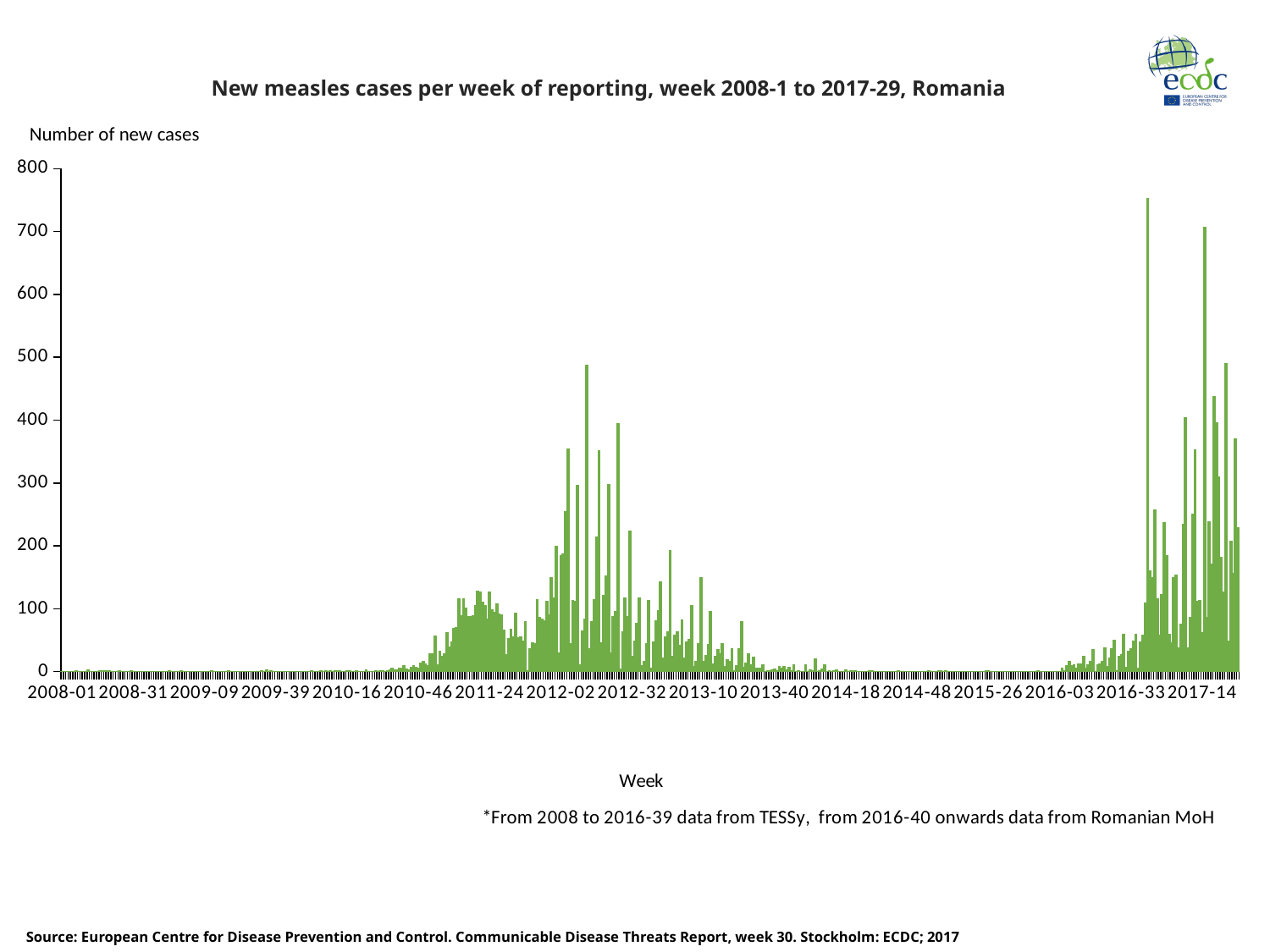
Is the tallest bar between the 2010-46 and 2011-24 ticks greater or less than 200? less Are the weekly values between the 2014-48 and 2015-26 ticks greater or less than 100? less What is the label of the vertical axis? Number of new cases Is the tallest bar in the chart located between the 2012-02 and 2012-32 ticks or between the 2016-33 and 2017-14 ticks? Between 2016-33 and 2017-14 Is the tallest bar between the 2012-02 and 2012-32 ticks greater or less than 400? greater Do the weekly values generally rise or fall from the 2016-03 tick to the 2016-33 tick? rise What is the title of the chart? New measles cases per week of reporting, week 2008-1 to 2017-29, Romania Do the weekly values generally rise or fall from the 2012-32 tick to the 2013-40 tick? fall What kind of chart is shown on the slide? Bar chart